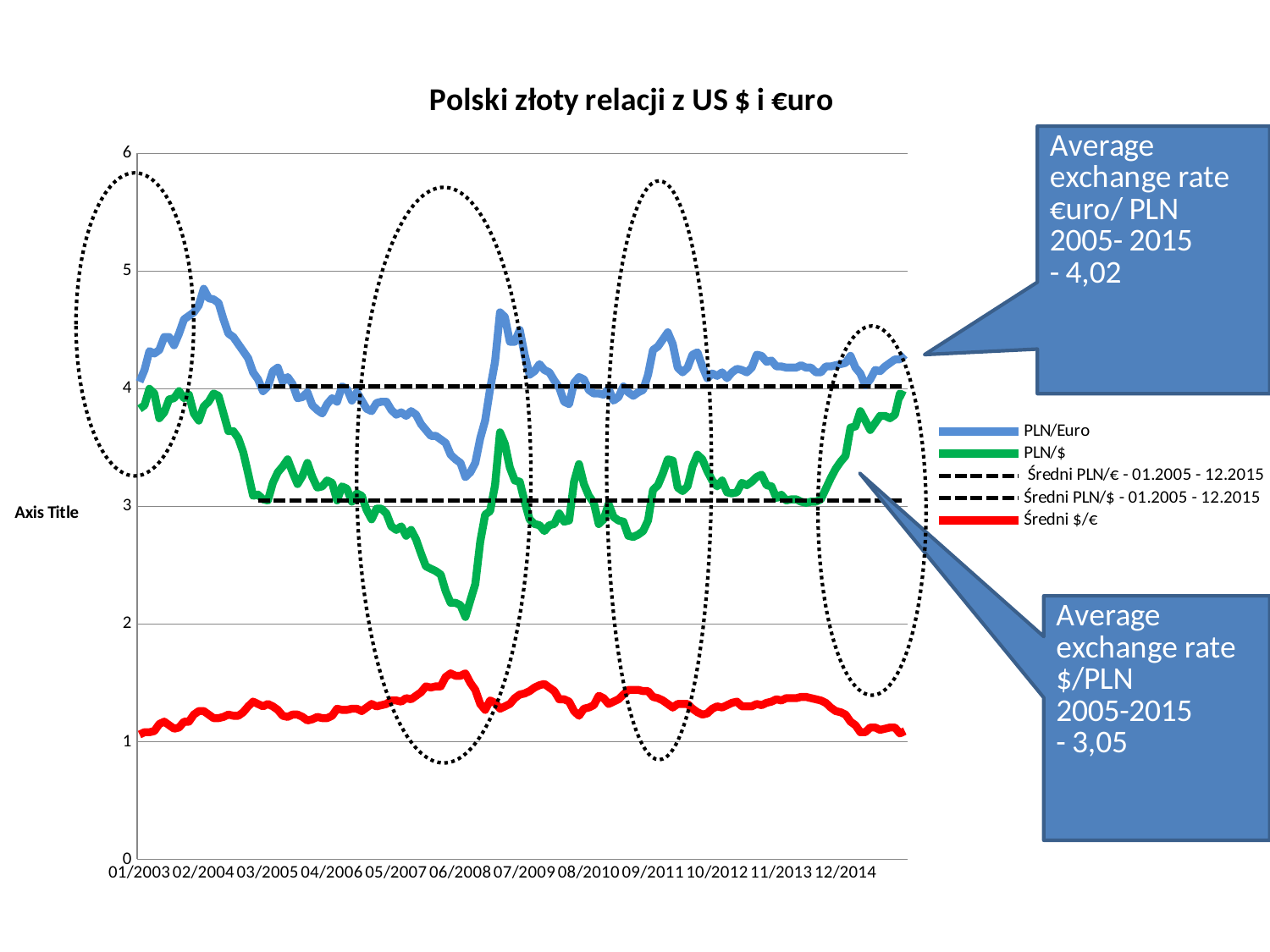
Is the PLN/Euro value at 12/2014 greater or less than 5? less Which series is drawn in red? Średni $/€ Is the PLN/$ value around 06/2008 greater or less than 3? less Does the PLN/$ series rise or fall between 03/2005 and 06/2008? fall How many series does the legend list? 5 According to the callout, what is the average €uro/PLN exchange rate for 2005-2015? 4,02 What kind of chart is shown on the slide? line chart According to the callout, what is the average $/PLN exchange rate for 2005-2015? 3,05 Is the Średni $/€ series greater or less than 2 throughout the chart? less What is the title of the chart? Polski złoty relacji z US $ i €uro Which series is plotted higher on the chart, PLN/Euro or PLN/$? PLN/Euro